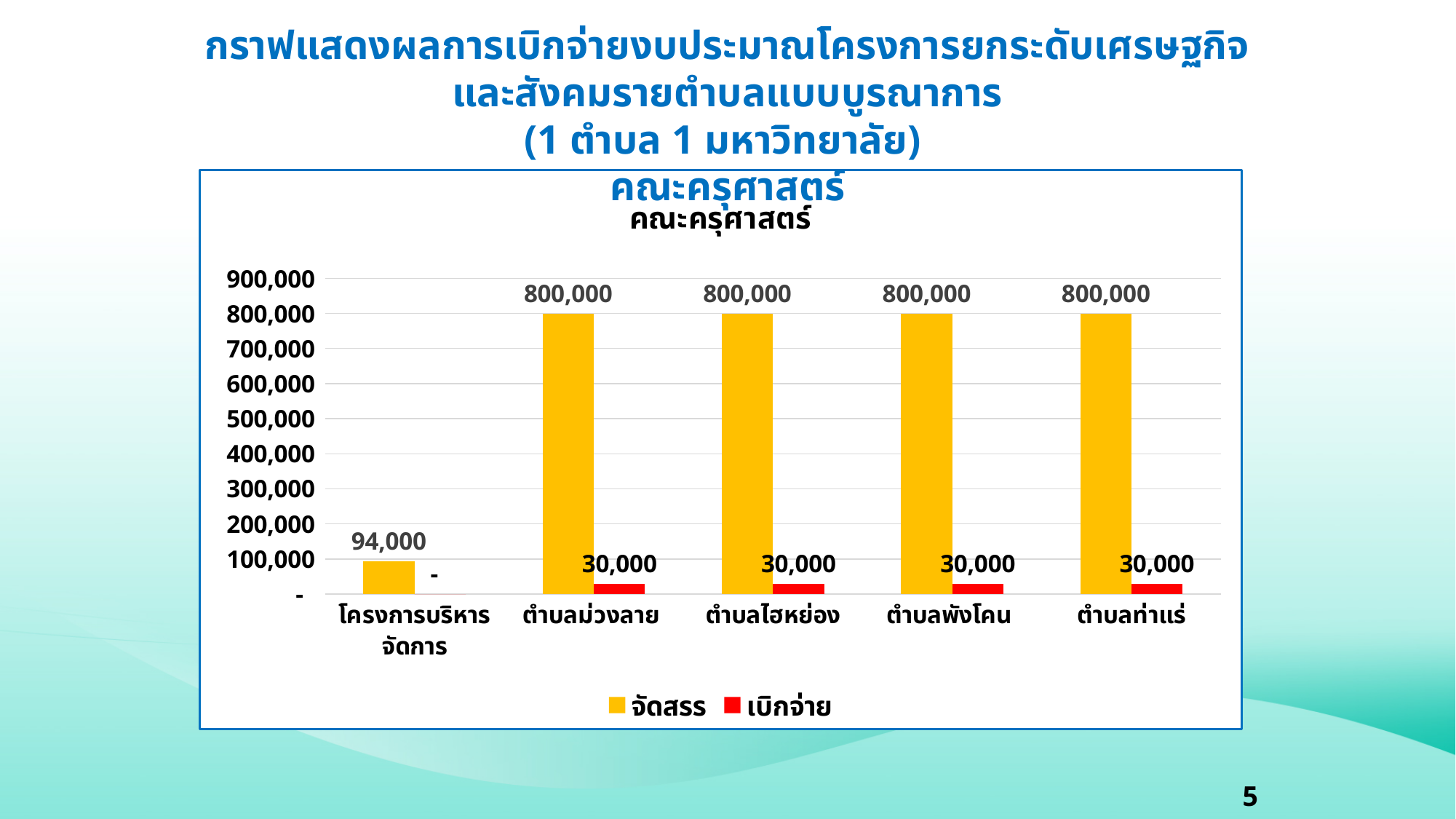
Which category has the lowest จัดสรร value? โครงการบริหารจัดการ What is the จัดสรร value for ตำบลม่วงลาย? 800,000 What is the title of the chart? คณะครุศาสตร์ Which is larger for ตำบลไฮหย่อง: the จัดสรร value or the เบิกจ่าย value? จัดสรร What is the จัดสรร value for โครงการบริหารจัดการ? 94,000 What kind of chart is shown? bar chart How many categories are shown on the x axis? 5 What is the เบิกจ่าย value for ตำบลท่าแร่? 30,000 How many series does the legend list? 2 What is the เบิกจ่าย value for โครงการบริหารจัดการ? - Is the จัดสรร value for โครงการบริหารจัดการ greater or less than 200,000? less What is the difference between the จัดสรร and เบิกจ่าย values for ตำบลพังโคน? 770,000